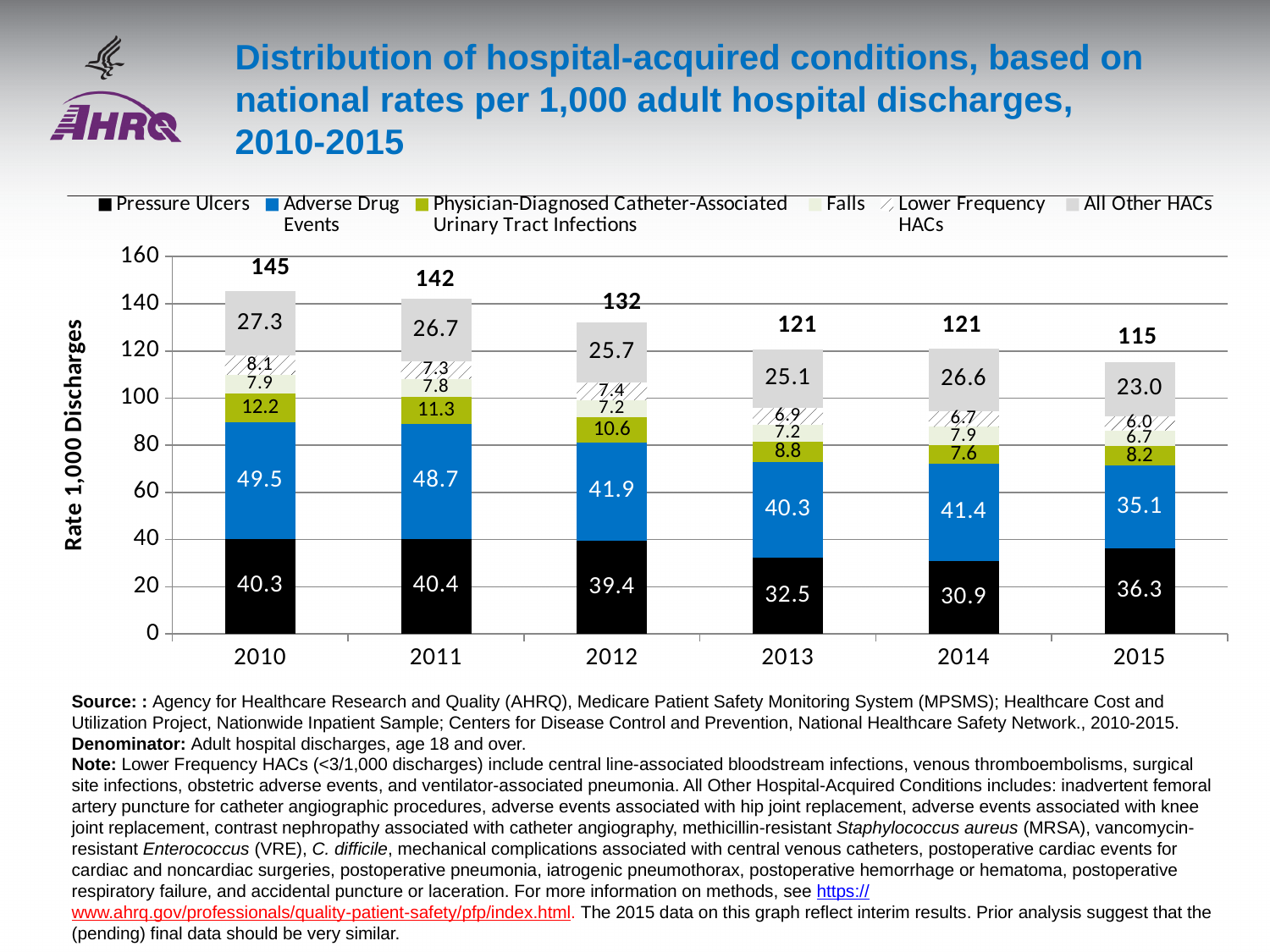
How many years are shown on the x axis? 6 What kind of chart is shown on the slide? Stacked bar chart What is the value for Pressure Ulcers in 2014? 30.9 Which year has the highest value for Adverse Drug Events? 2010 How many series does the legend list? 6 What is the value for Physician-Diagnosed Catheter-Associated Urinary Tract Infections in 2013? 8.8 Which year has the lowest total rate? 2015 What is the total rate shown above the stacked bar for 2010? 145 What is the value for All Other HACs in 2015? 23.0 What is the difference between the total rate in 2010 and the total rate in 2015? 30 Which is larger in 2015, the value for Pressure Ulcers or the value for Adverse Drug Events? Pressure Ulcers What is the value for Adverse Drug Events in 2012? 41.9